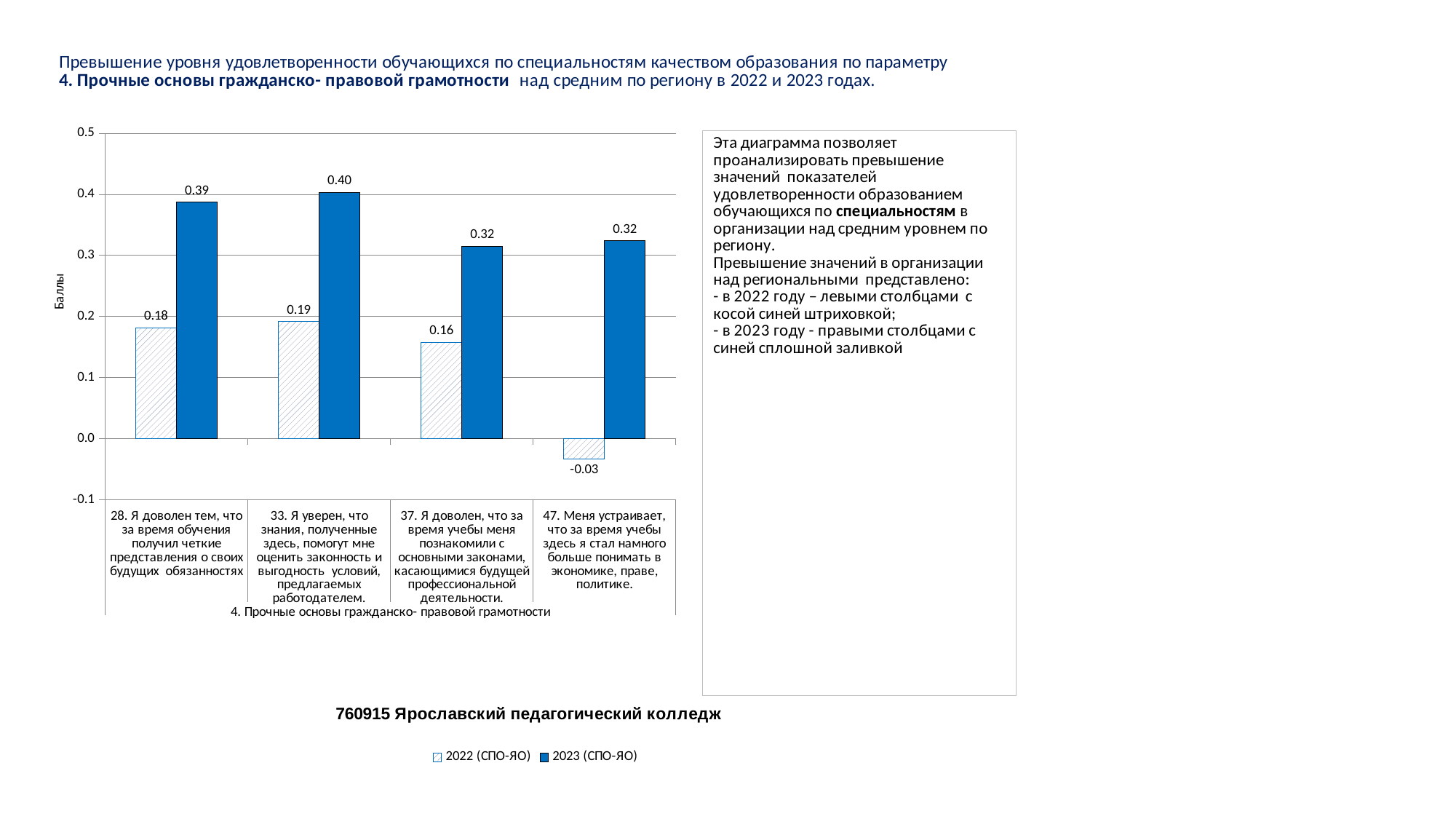
What is the difference between the 2023 and 2022 values for category 37 (Я доволен, что за время учебы меня познакомили с основными законами, касающимися будущей профессиональной деятельности)? 0.16 For category 28, which series has the larger value, 2022 (СПО-ЯО) or 2023 (СПО-ЯО)? 2023 (СПО-ЯО) Which category has the highest value for the 2023 (СПО-ЯО) series? 33. Я уверен, что знания, полученные здесь, помогут мне оценить законность и выгодность условий, предлагаемых работодателем. What is the value for 2023 (СПО-ЯО) for category 33 (Я уверен, что знания, полученные здесь, помогут мне оценить законность и выгодность условий, предлагаемых работодателем)? 0.40 How many series does the chart legend list? 2 What is the label of the vertical axis of the chart? Баллы What kind of chart is shown on the slide? Bar chart What is the value for 2022 (СПО-ЯО) for category 28 (Я доволен тем, что за время обучения получил четкие представления о своих будущих обязанностях)? 0.18 Which category has the lowest value for the 2022 (СПО-ЯО) series? 47. Меня устраивает, что за время учебы здесь я стал намного больше понимать в экономике, праве, политике. What is the value for 2022 (СПО-ЯО) for category 47 (Меня устраивает, что за время учебы здесь я стал намного больше понимать в экономике, праве, политике)? -0.03 How many categories are shown on the x axis of the chart? 4 Is the 2023 (СПО-ЯО) value for category 47 greater or less than 0.3? greater